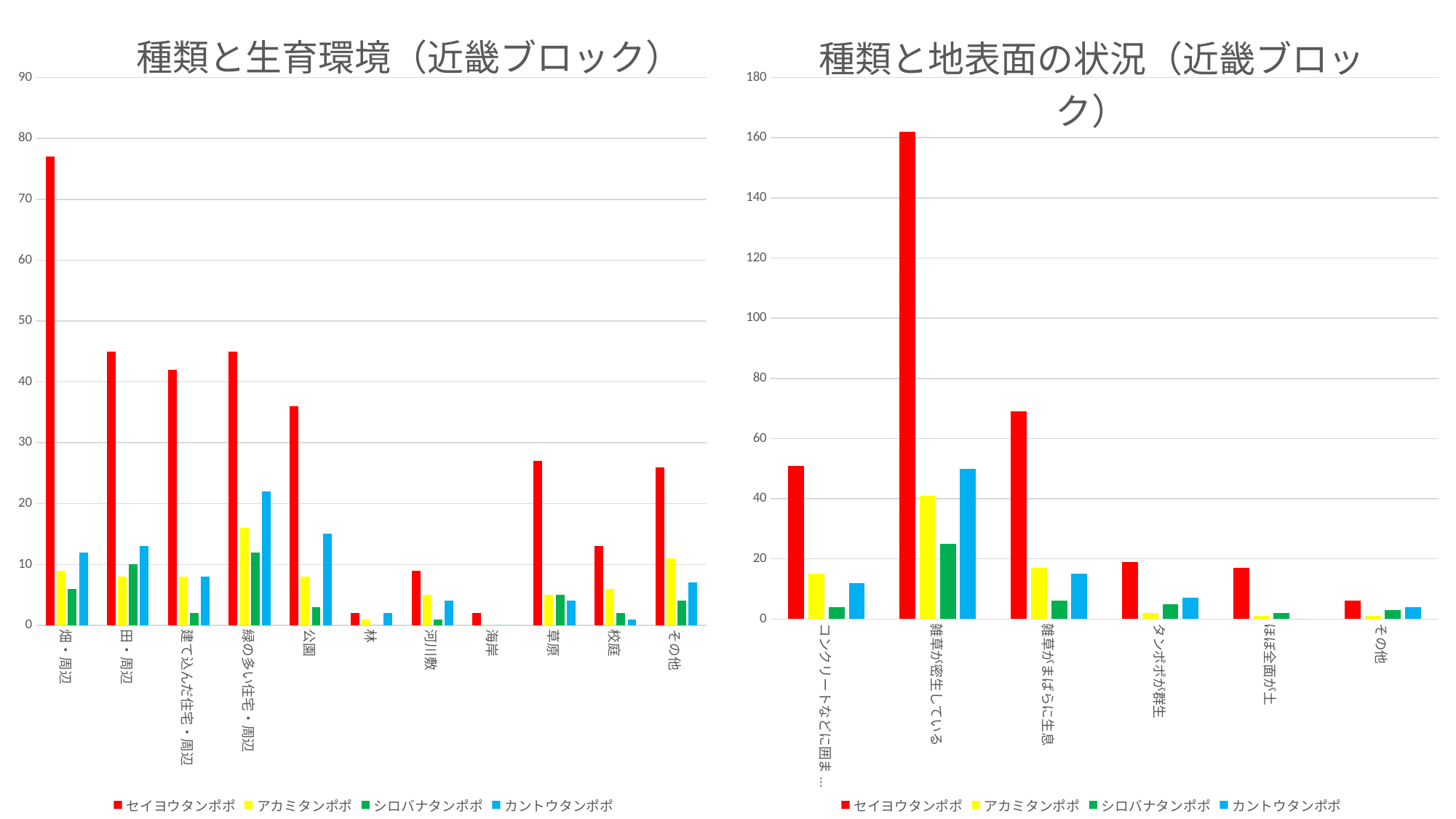
In the chart titled 種類と地表面の状況（近畿ブロック）, for 雑草がまばらに生息, which is larger: アカミタンポポ or シロバナタンポポ? アカミタンポポ In the chart titled 種類と生育環境（近畿ブロック）, which category has the highest value for セイヨウタンポポ? 畑・周辺 In the chart titled 種類と生育環境（近畿ブロック）, for 緑の多い住宅・周辺, which is larger: アカミタンポポ or カントウタンポポ? カントウタンポポ In the chart titled 種類と地表面の状況（近畿ブロック）, is the value for カントウタンポポ in 雑草が密生している greater or less than 40? greater What kind of chart is the chart titled 種類と地表面の状況（近畿ブロック）? bar chart In the chart titled 種類と地表面の状況（近畿ブロック）, which category has the highest value for セイヨウタンポポ? 雑草が密生している In the chart titled 種類と地表面の状況（近畿ブロック）, is the value for セイヨウタンポポ in 雑草が密生している greater or less than 140? greater In the chart titled 種類と生育環境（近畿ブロック）, how many categories are shown on the x axis? 11 In the chart titled 種類と地表面の状況（近畿ブロック）, how many categories are shown on the x axis? 6 In the chart titled 種類と生育環境（近畿ブロック）, is the value for セイヨウタンポポ in 畑・周辺 greater or less than 70? greater In the chart titled 種類と生育環境（近畿ブロック）, how many series does the legend list? 4